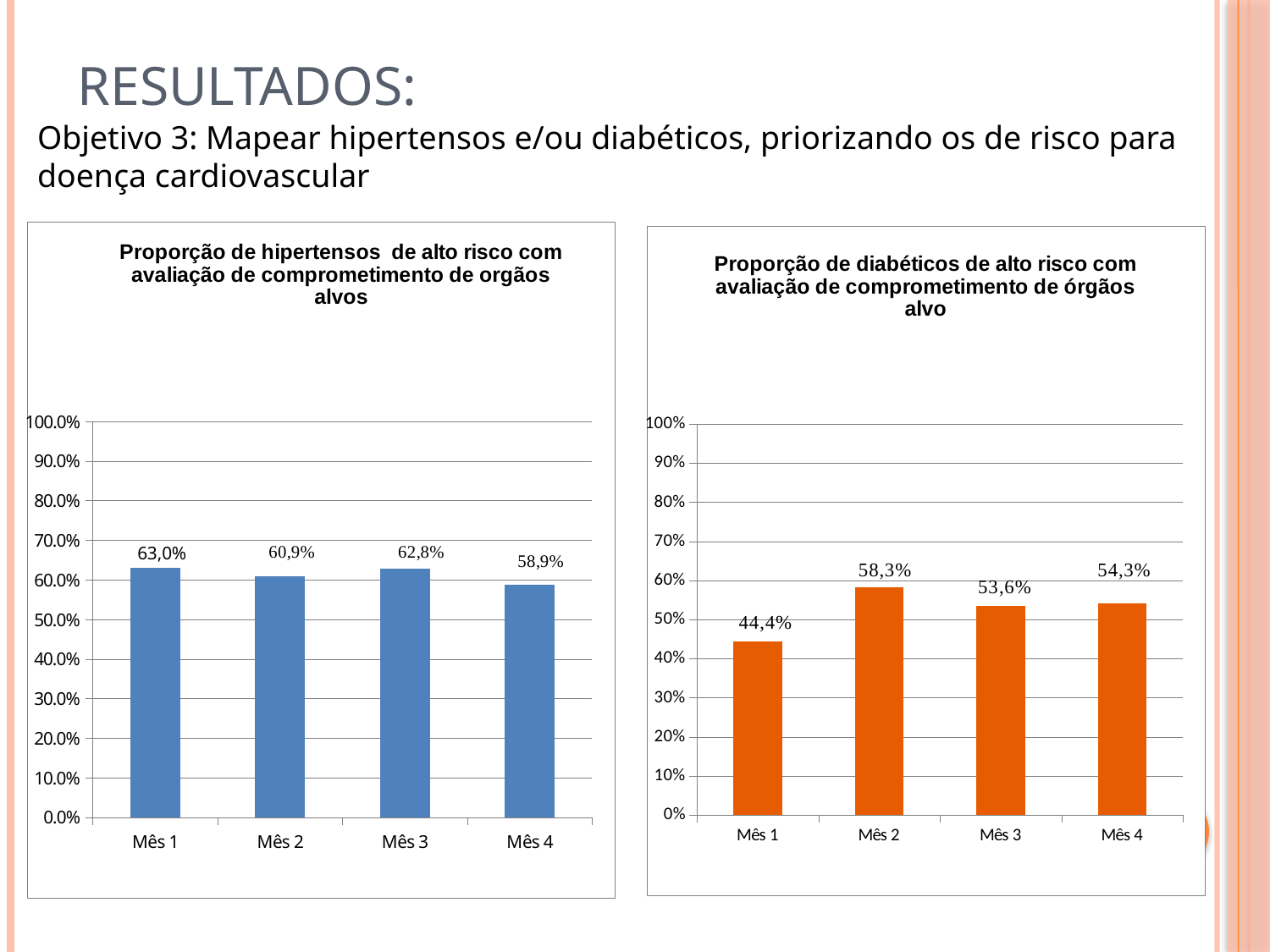
In the right chart (diabéticos), which is larger, the value for Mês 1 or the value for Mês 4? Mês 4 What type of chart is the right chart (diabéticos)? Bar chart In the left chart (hipertensos), what is the difference between the values for Mês 1 and Mês 4? 4,1% In the right chart (diabéticos), which month has the highest value? Mês 2 In the left chart (hipertensos), which month has the highest value? Mês 1 In the left chart (Proporção de hipertensos de alto risco com avaliação de comprometimento de orgãos alvos), what is the value for Mês 1? 63,0% In the left chart (hipertensos), what is the value for Mês 4? 58,9% In the right chart (diabéticos), what is the value for Mês 3? 53,6% In the right chart (diabéticos), which month has the lowest value? Mês 1 How many months (categories) are shown in the left chart (hipertensos)? 4 In the right chart (diabéticos), what is the difference between the values for Mês 2 and Mês 1? 13,9% In the right chart (Proporção de diabéticos de alto risco com avaliação de comprometimento de órgãos alvo), what is the value for Mês 1? 44,4%